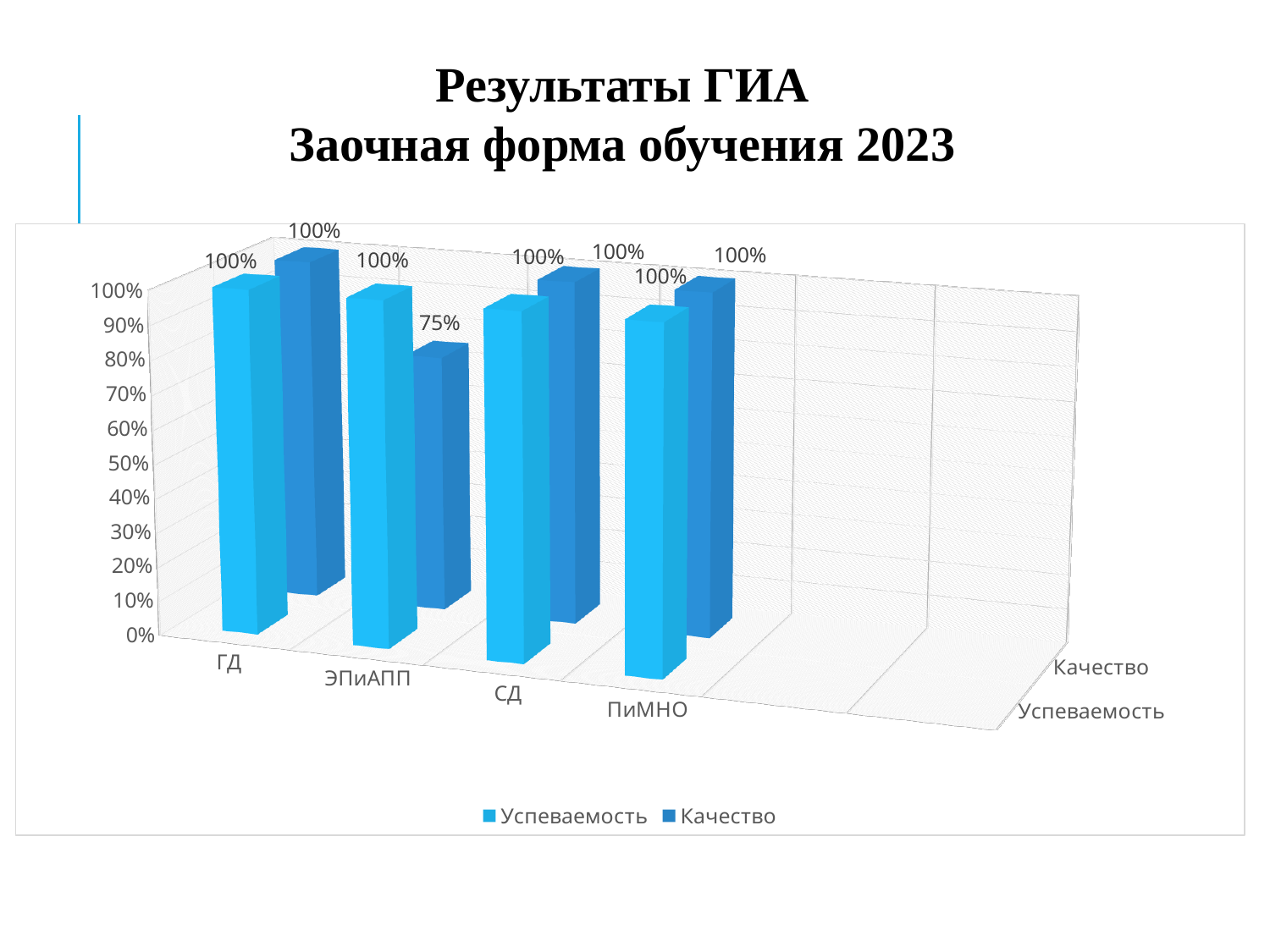
What is the title of the chart on the slide? Результаты ГИА Заочная форма обучения 2023 How many series does the legend list? 2 What is the Качество value for ЭПиАПП? 75% What is the Успеваемость value for ГД? 100% What is the difference between the Успеваемость and Качество values for ЭПиАПП? 25% What is the Качество value for СД? 100% What is the Успеваемость value for ПиМНО? 100% What kind of chart is shown on the slide? bar chart Is the Качество value for ЭПиАПП greater or less than 80%? less How many categories are shown on the x axis? 4 Which category has the lowest Качество value? ЭПиАПП Which is larger for ЭПиАПП, Успеваемость or Качество? Успеваемость